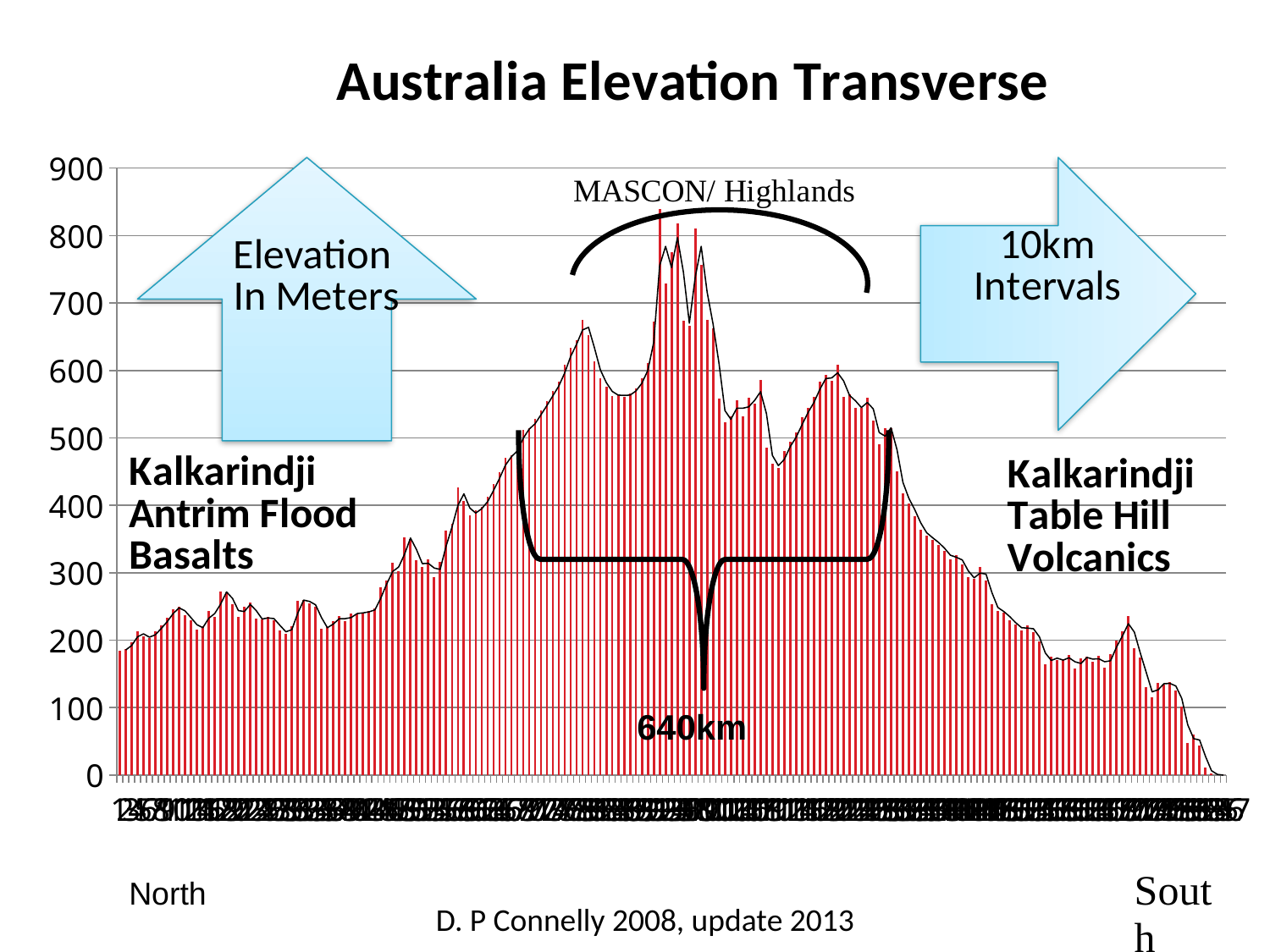
Is the value at the far right end of the x axis greater or less than 100? less What is the title of the chart? Australia Elevation Transverse Is the value at the far left end of the x axis greater or less than 300? less Do the values rise or fall moving from the central peak toward the right edge of the chart? fall Is the highest value plotted on the chart greater or less than 900? less What is the highest tick value shown on the vertical axis? 900 What kind of chart is shown on the slide? bar chart Do the values rise or fall moving from the left edge of the chart toward the central peak? rise